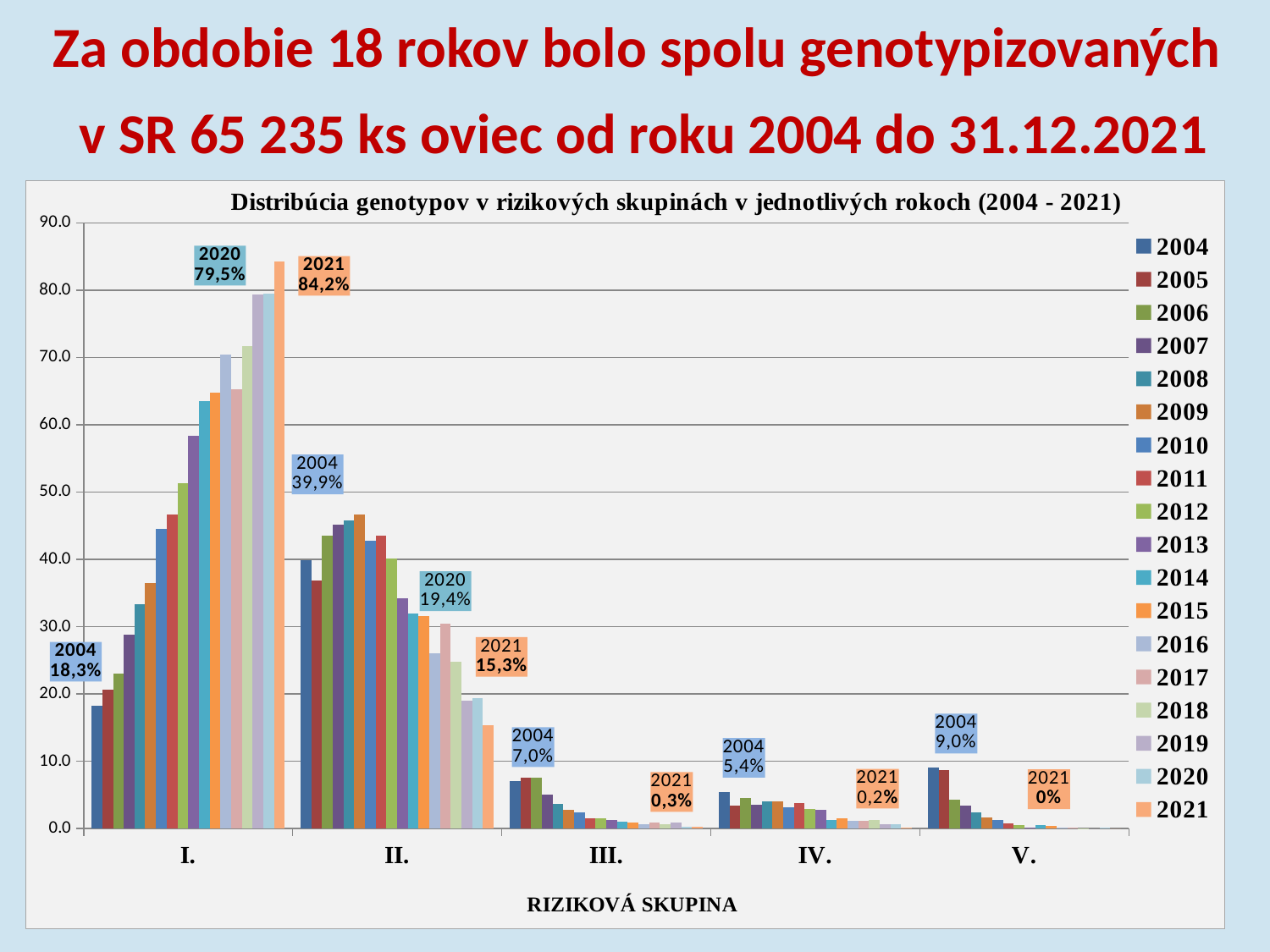
What is the labelled value for 2004 in risk group II.? 39,9% How many series (years) does the legend list? 18 How many risk group categories are shown on the x axis? 5 What is the title of the chart? Distribúcia genotypov v rizikových skupinách v jednotlivých rokoch (2004 - 2021) What is the difference between the 2021 and 2004 values in risk group I.? 65,9% What is the labelled value for 2020 in risk group II.? 19,4% What kind of chart is shown on the slide? bar chart What is the labelled value for 2021 in risk group I.? 84,2% What is the labelled value for 2021 in risk group V.? 0% Which is larger in risk group II.: the 2004 value or the 2021 value? 2004 In risk group I., do the values rise or fall from 2004 to 2021? rise Is the value for 2021 in risk group I. greater or less than 80? greater